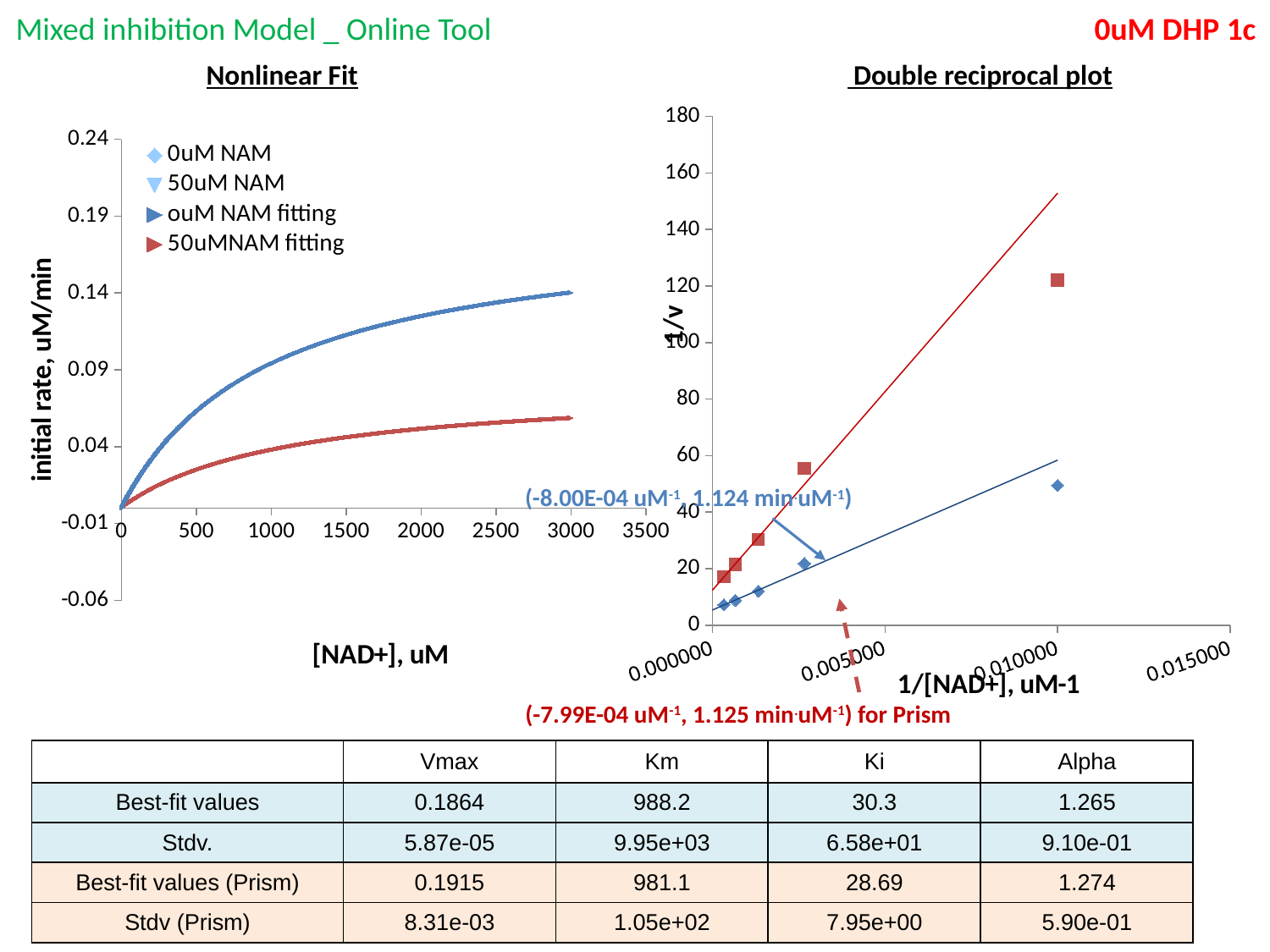
In the Double reciprocal plot, does 1/v rise or fall as 1/[NAD+] increases? rises In the Double reciprocal plot, is the 1/v value of the red square at 1/[NAD+] of about 0.010000 greater or less than 100? greater In the Nonlinear Fit chart, which fitting curve is higher at [NAD+] = 3000 uM, ouM NAM fitting or 50uMNAM fitting? ouM NAM fitting In the Nonlinear Fit chart, does the ouM NAM fitting curve rise or fall as [NAD+] increases? rises How many series does the legend of the Nonlinear Fit chart list? 4 What kind of chart is the Nonlinear Fit chart on the left? line chart In the Nonlinear Fit chart, is the ouM NAM fitting value at [NAD+] = 3000 uM greater or less than 0.09? greater What is the y-axis title of the Nonlinear Fit chart? initial rate, uM/min In the Nonlinear Fit chart, is the 50uMNAM fitting value at [NAD+] = 3000 uM greater or less than 0.09? less In the Double reciprocal plot, which series has the steeper fitted line, the red squares or the blue diamonds? red squares What is the x-axis label of the Double reciprocal plot? 1/[NAD+], uM-1